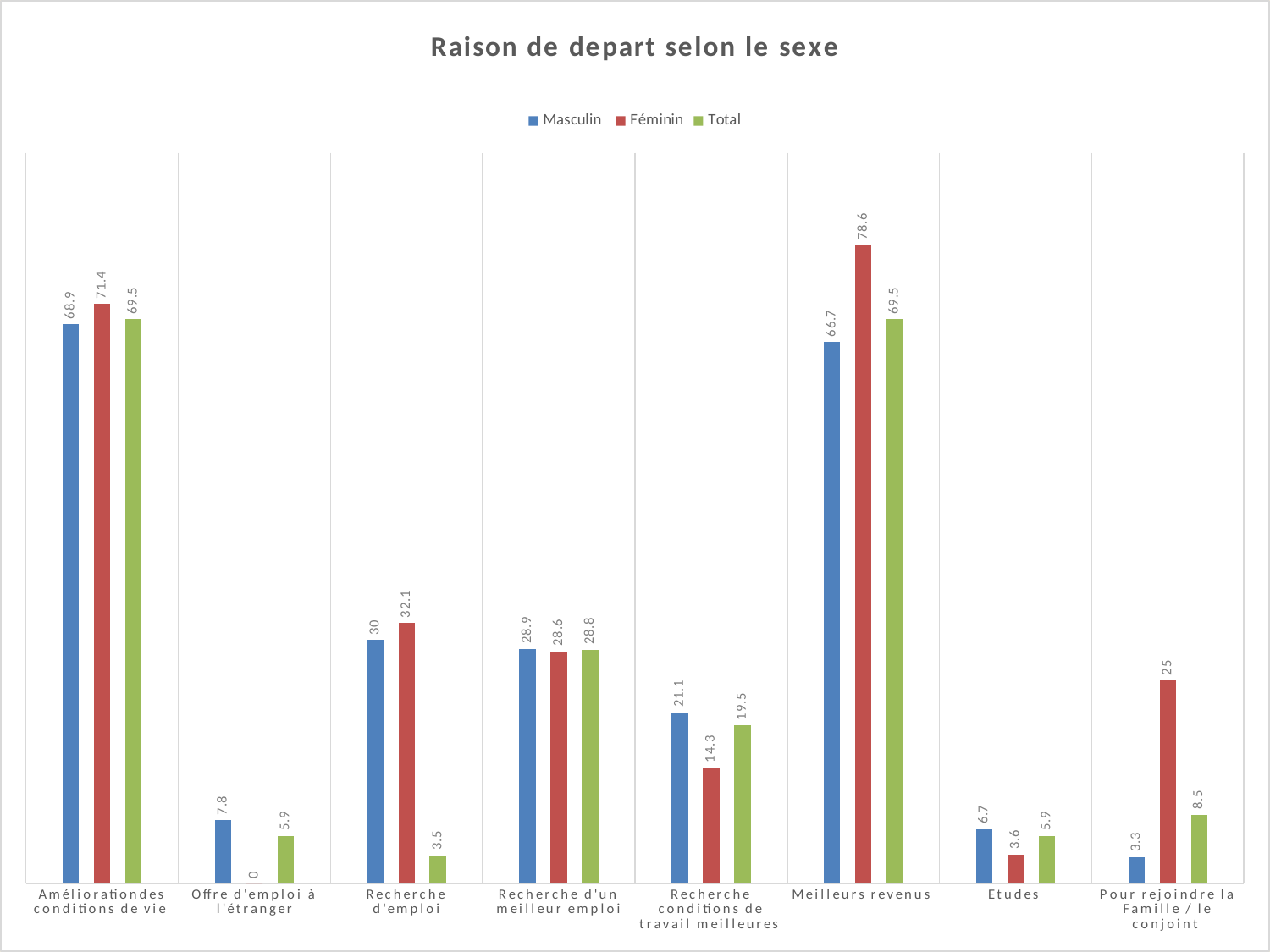
What is the title of the chart? Raison de depart selon le sexe What is the Féminin value for Offre d'emploi à l'étranger? 0 For Recherche conditions de travail meilleures, which is larger, the Masculin or the Féminin value? Masculin What is the difference between the Féminin and Masculin values for Pour rejoindre la Famille / le conjoint? 21.7 What is the Féminin value for Meilleurs revenus? 78.6 What is the Total value for Pour rejoindre la Famille / le conjoint? 8.5 What is the Masculin value for Recherche d'emploi? 30 Which category has the highest Féminin value? Meilleurs revenus How many categories are shown on the x axis? 8 What kind of chart is shown? Bar chart How many series does the legend list? 3 Which category has the lowest Masculin value? Pour rejoindre la Famille / le conjoint